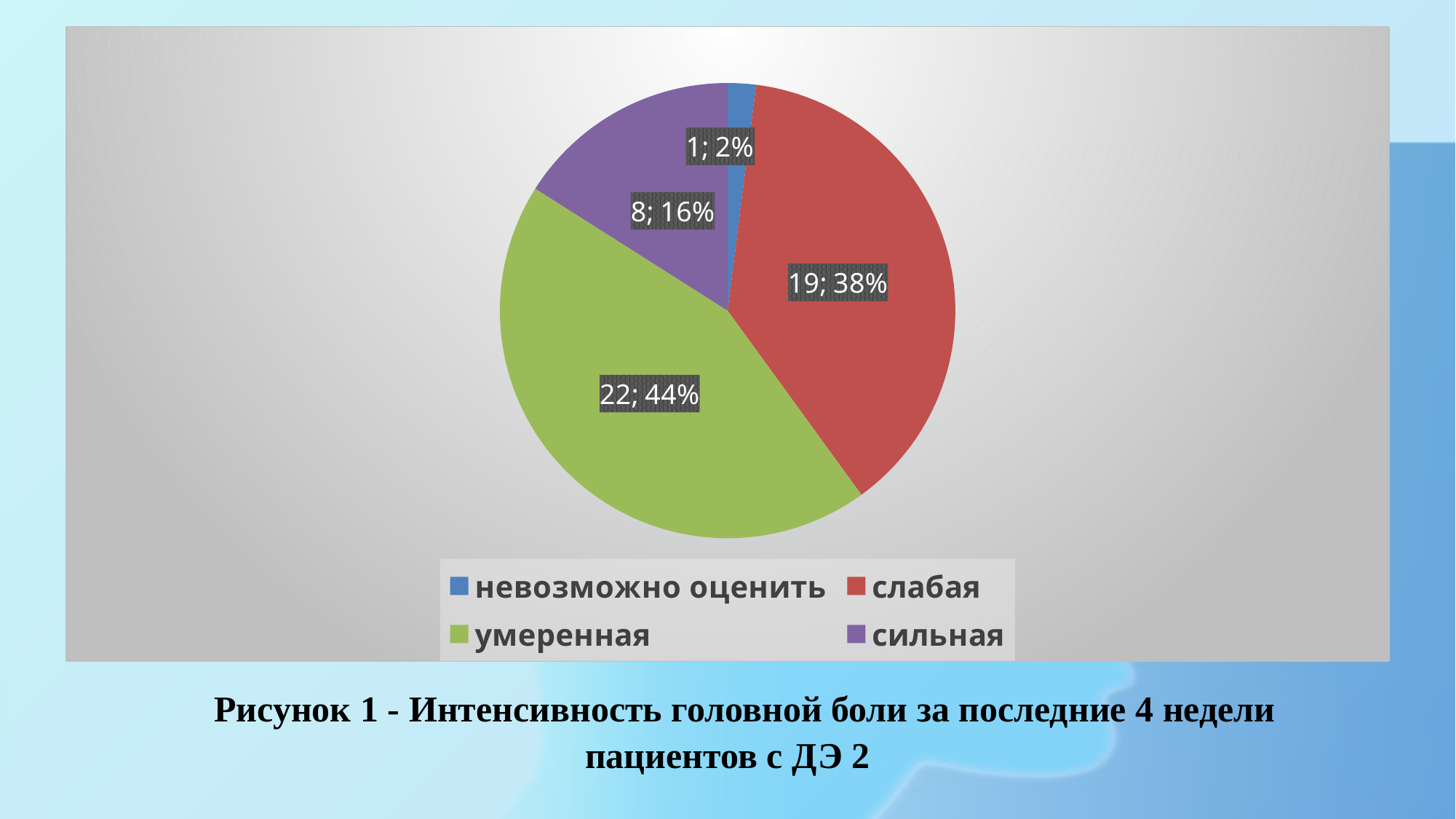
Which is larger, the 'сильная' slice or the 'слабая' slice? слабая How many slices does the pie chart have? 4 Which category has the smallest slice? невозможно оценить What percentage share does the 'невозможно оценить' slice have? 2% What is the count for the 'умеренная' slice? 22 What percentage share does the 'слабая' slice have? 38% Which category has the largest slice? умеренная What colour is the 'умеренная' slice? green How many entries does the legend list? 4 What is the difference in count between 'умеренная' and 'слабая'? 3 What kind of chart is shown on the slide? pie chart What is the count for the 'сильная' slice? 8